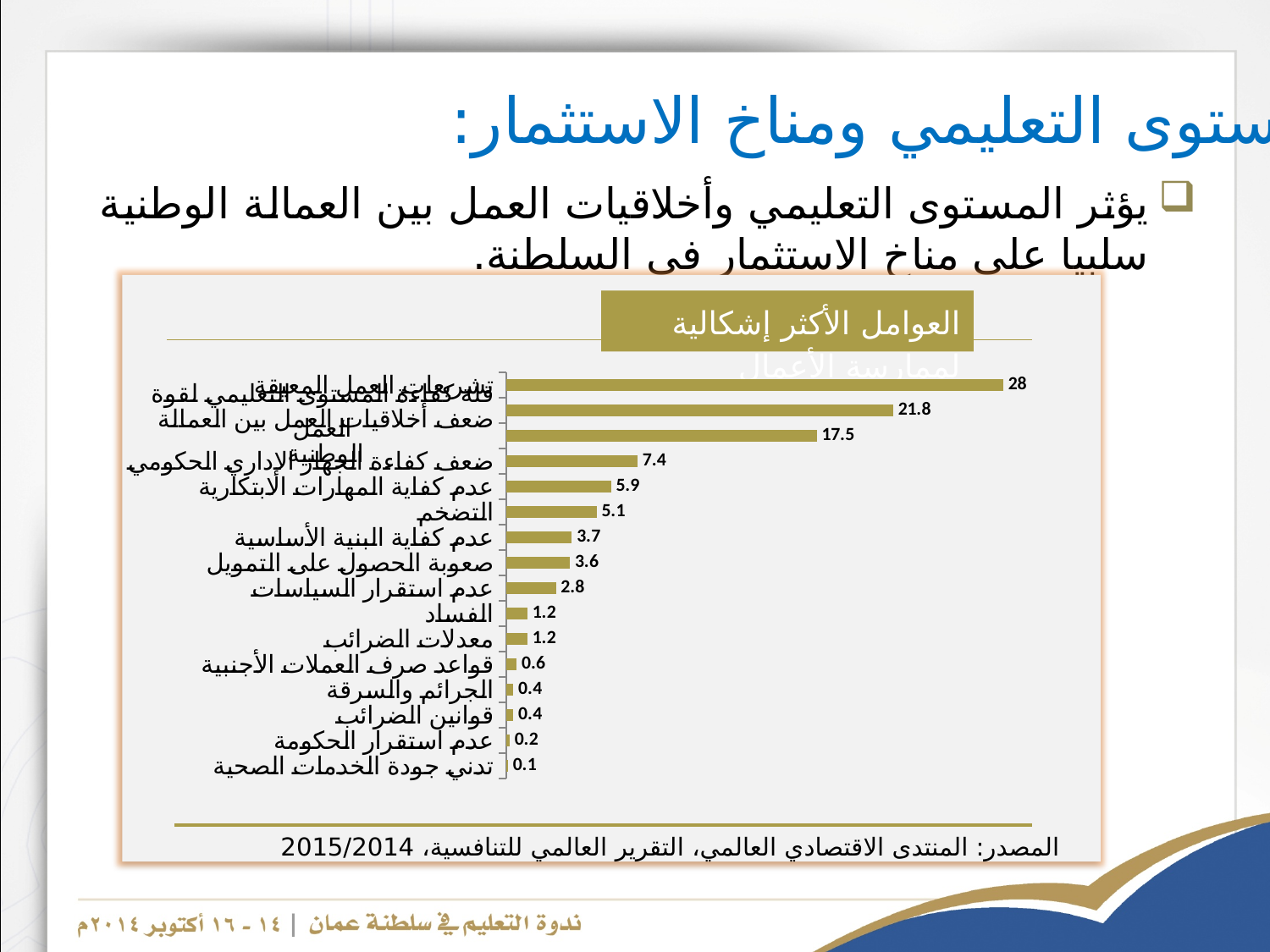
What is the value for الفساد (corruption)? 1.2 What is the largest value shown in the chart? 28 Which category has the lowest value in the chart? تدني جودة الخدمات الصحية What source is cited below the chart? المنتدى الاقتصادي العالمي، التقرير العالمي للتنافسية، 2015/2014 Which is larger: the value for التضخم or the value for عدم كفاية البنية الأساسية? التضخم How many bars (categories) are shown in the chart? 16 What is the difference between the values for التضخم and الفساد? 3.9 What is the value for التضخم (inflation)? 5.1 What type of chart is shown on the slide? bar chart What is the value for ضعف كفاءة الجهاز الإداري الحكومي (inefficient government bureaucracy)? 7.4 What is the value for عدم كفاية البنية الأساسية (inadequate infrastructure)? 3.7 Do the bar values increase or decrease going from the top of the chart to the bottom? decrease